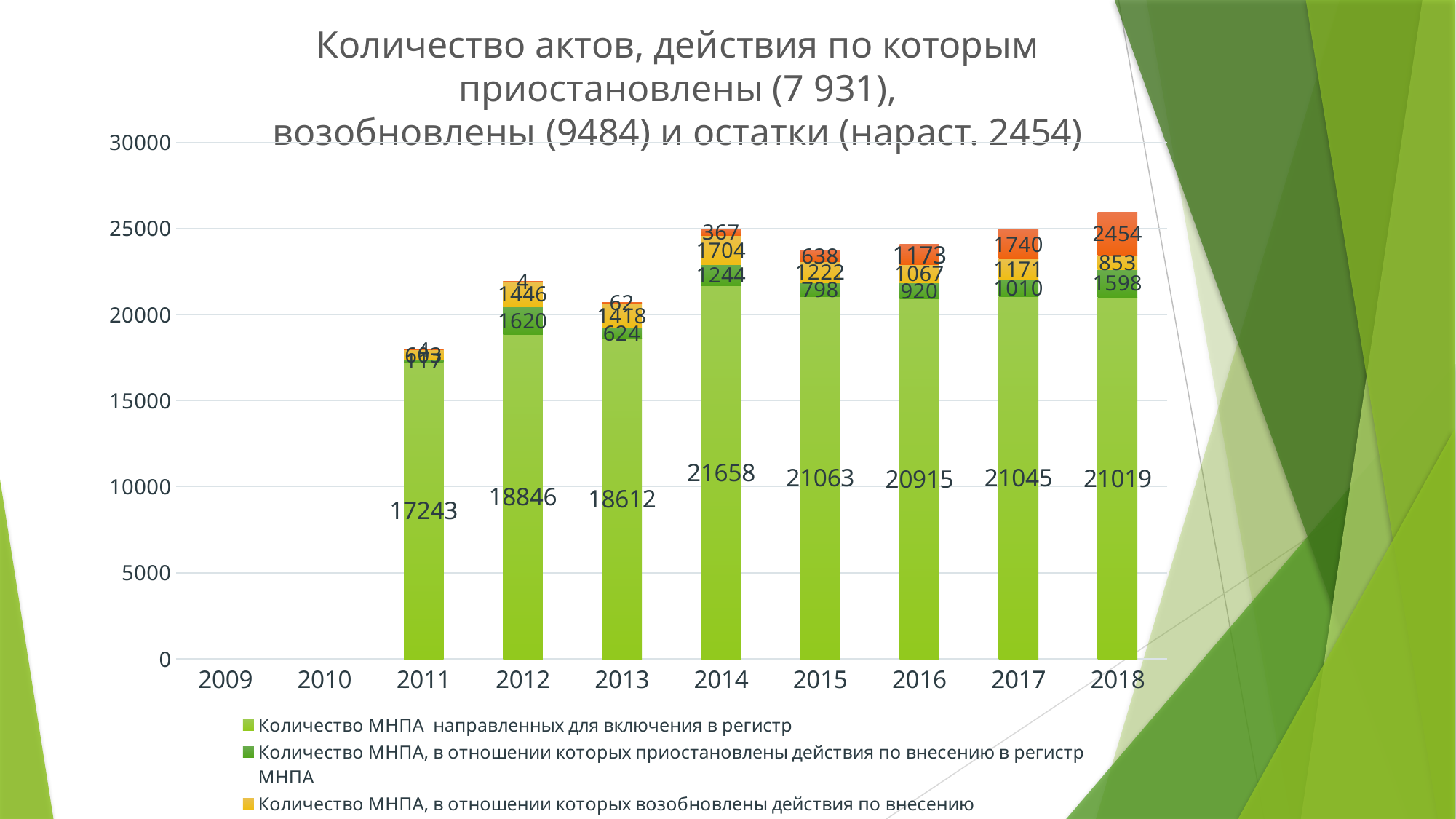
In which year is the 'Количество МНПА направленных для включения в регистр' value highest? 2014 What is the value of the 'Количество МНПА, в отношении которых приостановлены действия по внесению в регистр МНПА' series for 2012? 1620 What is the value of the 'Количество МНПА направленных для включения в регистр' series for 2014? 21658 Does the top (orange) segment rise or fall from 2014 to 2018? rises What is the difference between the 'Количество МНПА направленных для включения в регистр' values for 2014 and 2013? 3046 What is the total of the stacked bar for 2018? 25924 Which year has the larger 'Количество МНПА направленных для включения в регистр' value, 2016 or 2017? 2017 What is the value of the 'Количество МНПА, в отношении которых возобновлены действия по внесению' series for 2015? 1222 How many years on the x axis have bars plotted? 8 What is the value of the top (orange) segment of the 2018 bar? 2454 What kind of chart is shown on the slide? stacked bar chart In which year is the 'Количество МНПА направленных для включения в регистр' value lowest? 2011